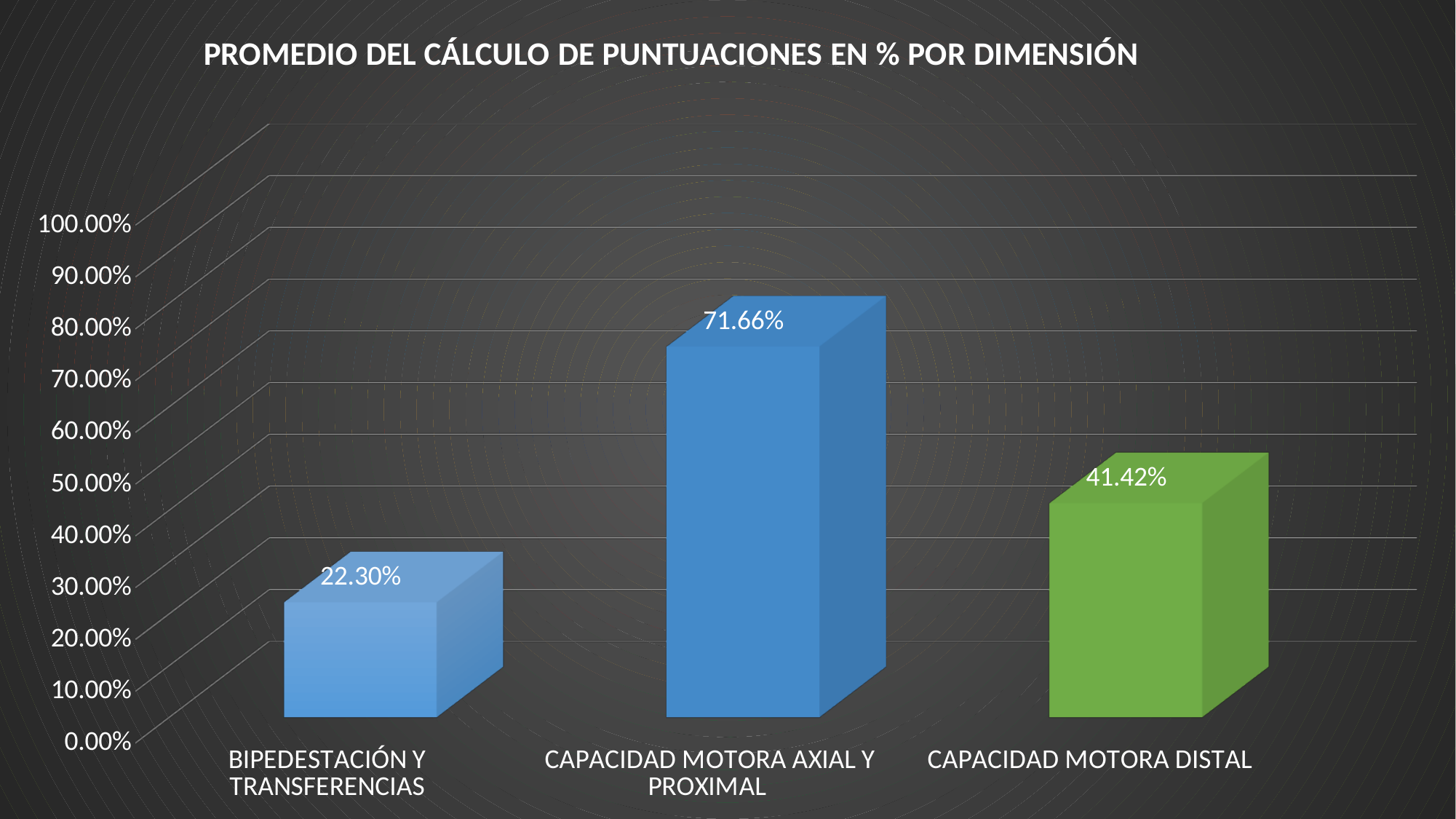
What kind of chart is shown on the slide? bar chart Which dimension has the highest value? CAPACIDAD MOTORA AXIAL Y PROXIMAL How many dimensions are shown in the chart? 3 What is the difference between the values for CAPACIDAD MOTORA DISTAL and BIPEDESTACIÓN Y TRANSFERENCIAS? 19.12% Is the value for CAPACIDAD MOTORA AXIAL Y PROXIMAL greater or less than 60.00%? greater What is the difference between the values for CAPACIDAD MOTORA AXIAL Y PROXIMAL and CAPACIDAD MOTORA DISTAL? 30.24% What is the value for CAPACIDAD MOTORA AXIAL Y PROXIMAL? 71.66% What is the value for CAPACIDAD MOTORA DISTAL? 41.42% What is the value for BIPEDESTACIÓN Y TRANSFERENCIAS? 22.30% Which is larger, the value for CAPACIDAD MOTORA DISTAL or the value for BIPEDESTACIÓN Y TRANSFERENCIAS? CAPACIDAD MOTORA DISTAL What is the title of the chart? PROMEDIO DEL CÁLCULO DE PUNTUACIONES EN % POR DIMENSIÓN Which dimension has the lowest value? BIPEDESTACIÓN Y TRANSFERENCIAS